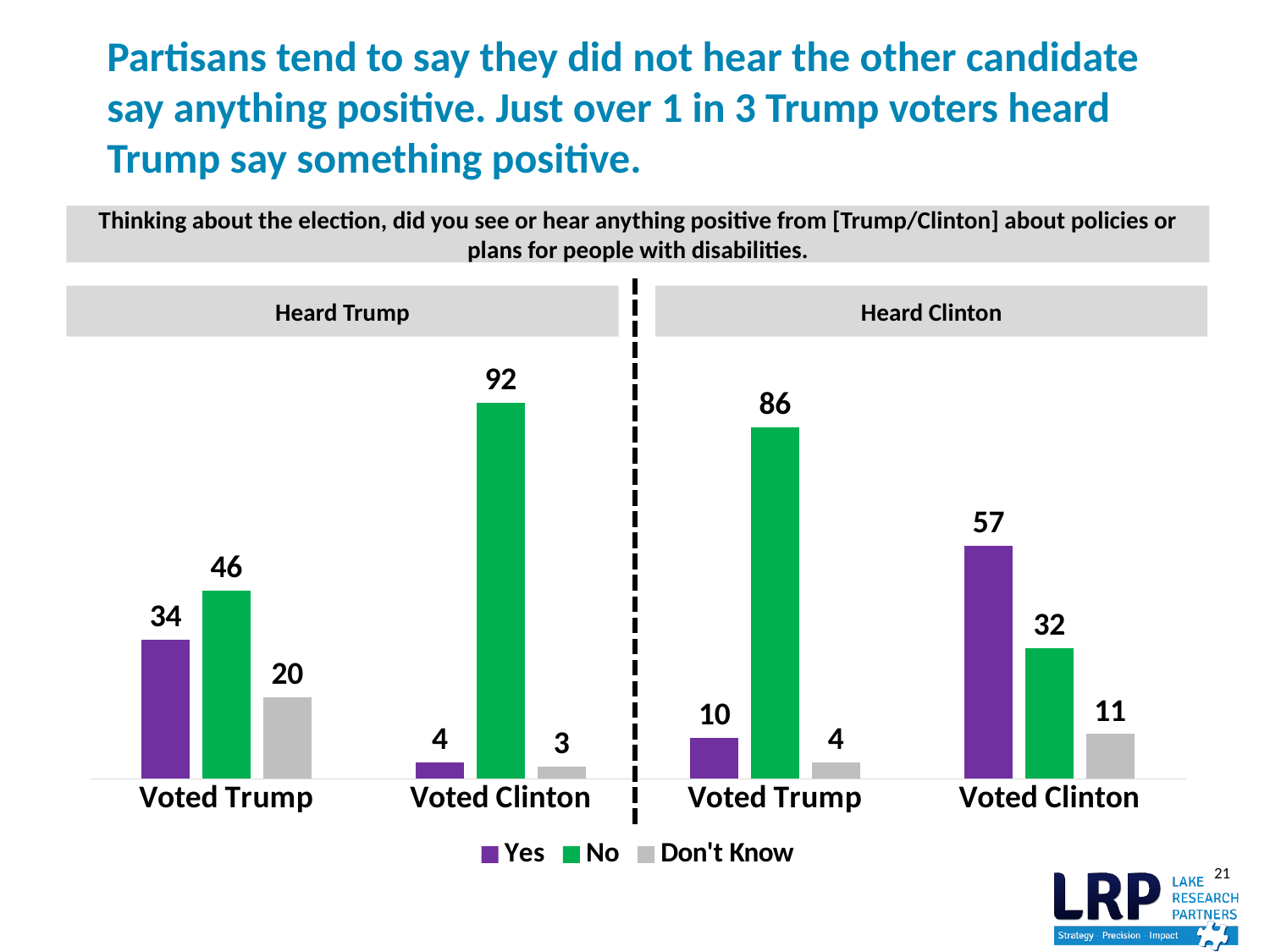
Which is larger: the Yes value for Voted Trump in the Heard Trump chart or the Yes value for Voted Clinton in the Heard Clinton chart? Yes value for Voted Clinton in the Heard Clinton chart In the Heard Trump chart, what is the value for No among those who Voted Clinton? 92 In the Heard Trump chart, what is the value for Yes among those who Voted Trump? 34 How many series does the legend list? 3 In the Heard Trump chart, which response is highest among those who Voted Clinton? No In the Heard Trump chart, what is the difference between the No and Yes values for those who Voted Trump? 12 What kind of chart is the Heard Trump chart? Bar chart In the Heard Clinton chart, what is the value for Don't Know among those who Voted Trump? 4 In the Heard Clinton chart, what is the value for Yes among those who Voted Clinton? 57 In the Heard Clinton chart, which response is lowest among those who Voted Clinton? Don't Know In the Heard Clinton chart, what is the difference between the No values for Voted Trump and Voted Clinton? 54 What colour are the No bars in the charts? Green